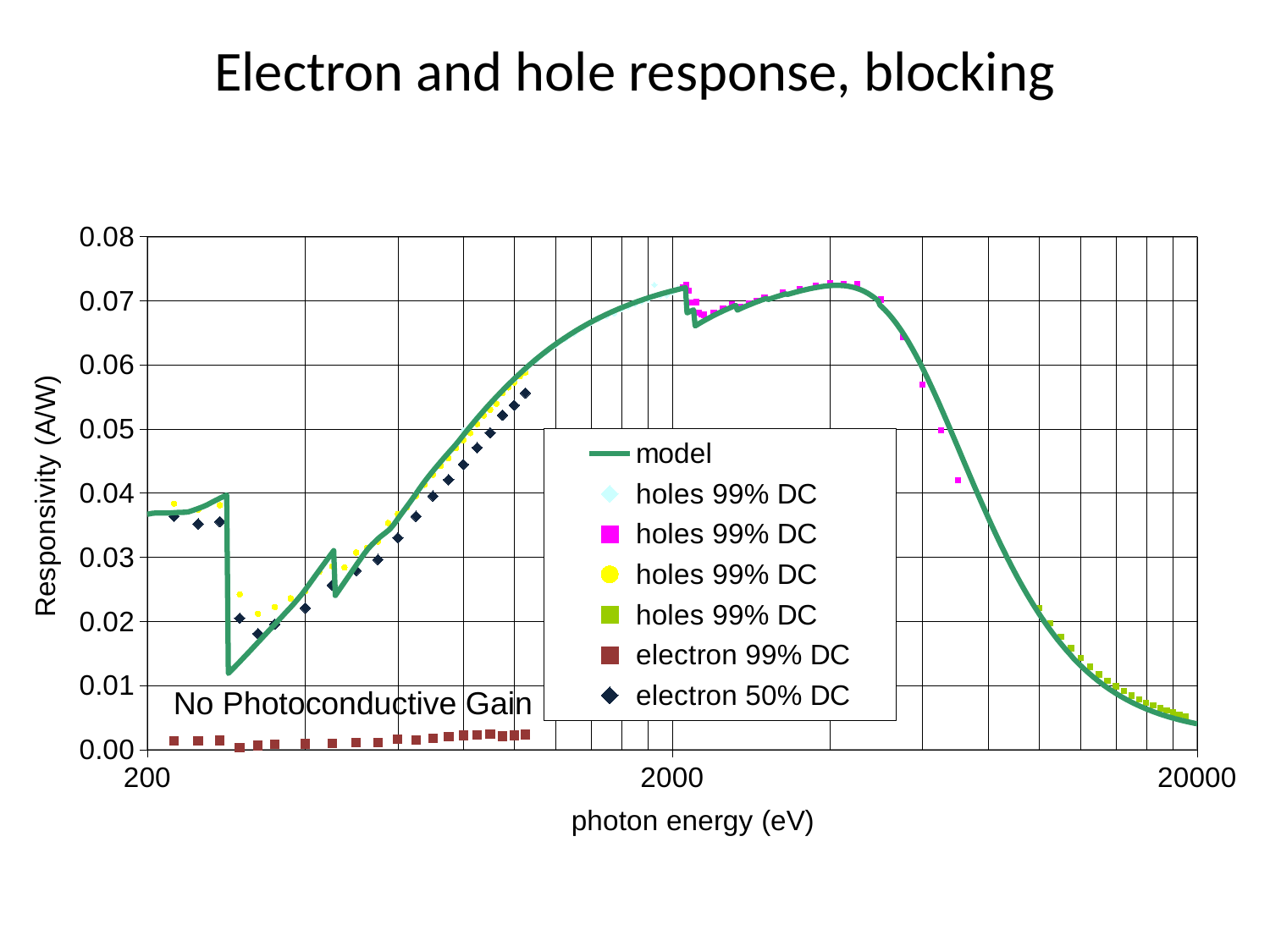
Which is larger at 1000 eV, the model value or the electron 99% DC value? model Is the model value at 20000 eV greater or less than 0.01? less What is the title of the chart? Electron and hole response, blocking Does the model curve rise or fall as photon energy increases from about 4000 eV to 20000 eV? fall Is the model value at 200 eV greater or less than 0.03? greater What is the label of the y axis? Responsivity (A/W) Is the peak value of the model curve greater or less than 0.06? greater What kind of chart is shown on the slide? line chart with scatter points How many series does the legend list? 7 Which series has the lowest responsivity values across the chart? electron 99% DC How many legend entries are labelled 'holes 99% DC'? 4